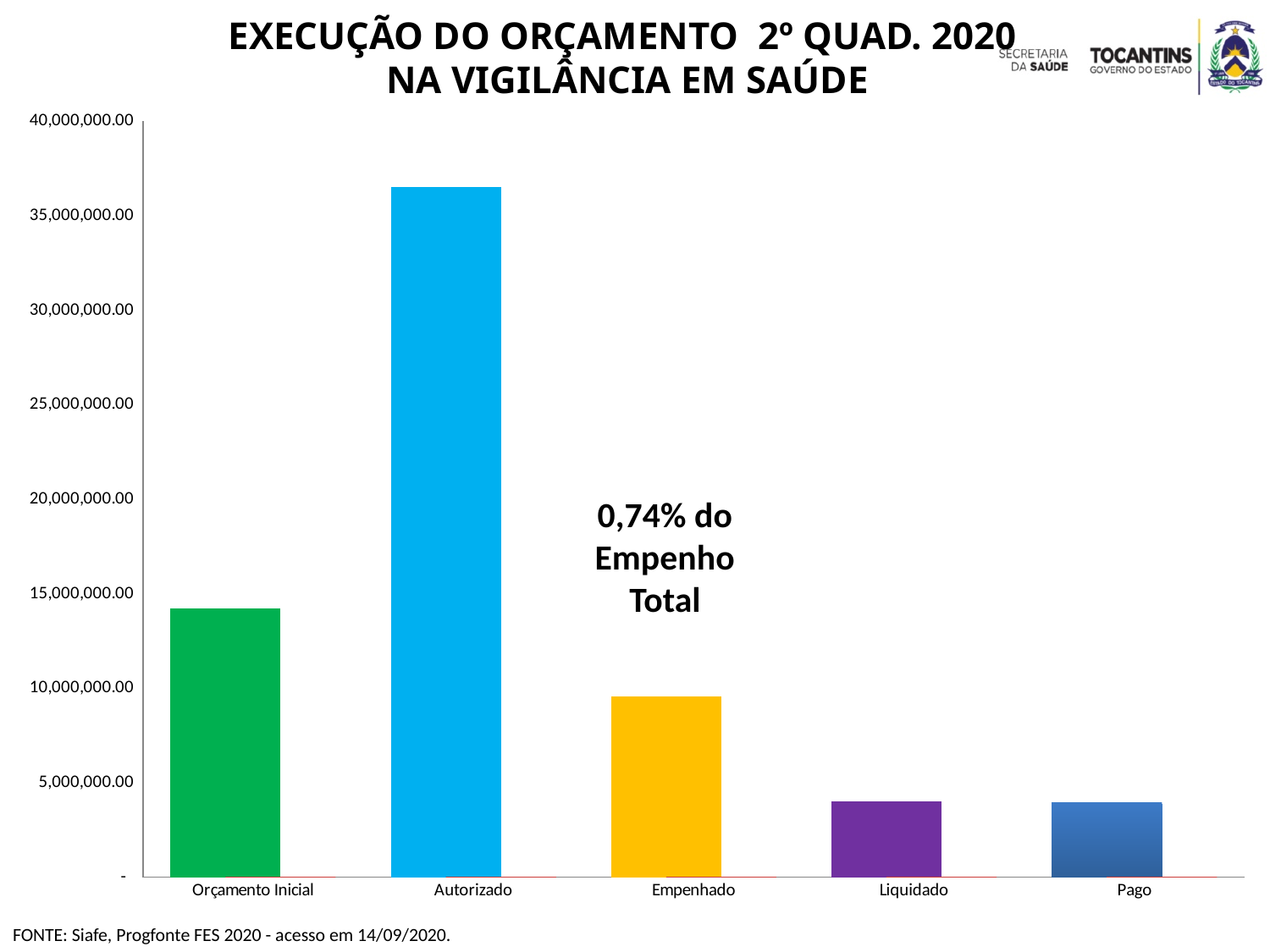
How many categories are plotted on the x axis? 5 Which is larger, the value for Empenhado or the value for Pago? Empenhado Is the value for Autorizado greater or less than 35,000,000.00? greater Is the value for Empenhado greater or less than 10,000,000.00? less Which is larger, the value for Orçamento Inicial or the value for Empenhado? Orçamento Inicial What kind of chart is shown on the slide? bar chart What is the title of the chart? EXECUÇÃO DO ORÇAMENTO 2º QUAD. 2020 NA VIGILÂNCIA EM SAÚDE Is the value for Liquidado greater or less than 5,000,000.00? less What percentage annotation is printed above the Empenhado bar? 0,74% do Empenho Total Which is larger, the value for Autorizado or the value for Orçamento Inicial? Autorizado Which category has the highest bar? Autorizado